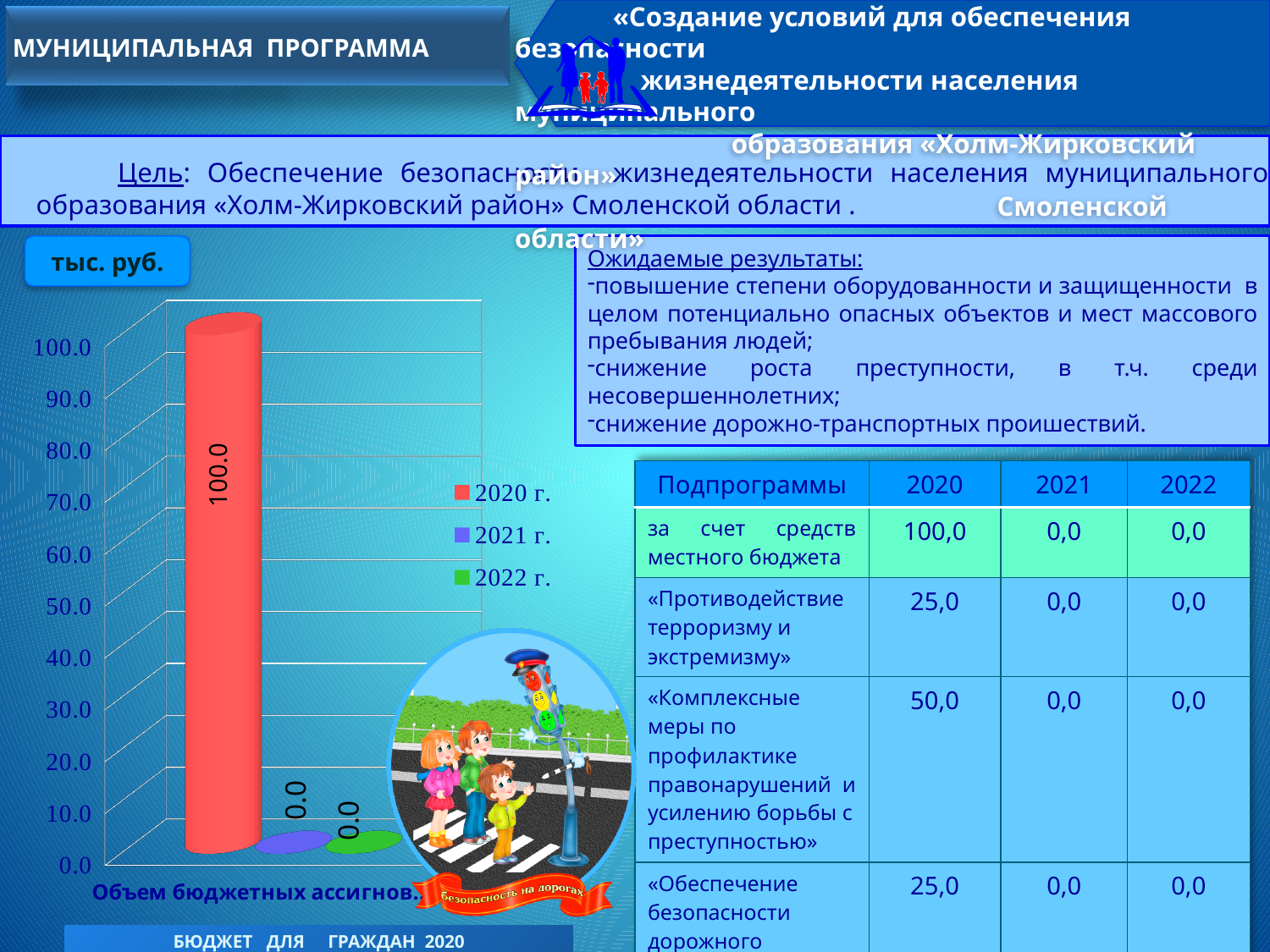
What kind of chart is shown on the slide? bar chart How many series does the chart legend list? 3 What is the value for the 2022 г. series in the chart? 0.0 Which is larger in the chart, the value for 2020 г. or the value for 2022 г.? 2020 г. What is the value for the 2020 г. series in the chart? 100.0 Which series has the highest value in the chart? 2020 г. What is the difference between the 2020 г. value and the 2021 г. value in the chart? 100.0 What unit is indicated for the chart values? тыс. руб. What colour is the bar for the 2020 г. series in the chart? red What is the highest tick value shown on the chart's vertical axis? 100.0 What is the value for the 2021 г. series in the chart? 0.0 Is the value for 2020 г. in the chart greater or less than 50.0? greater